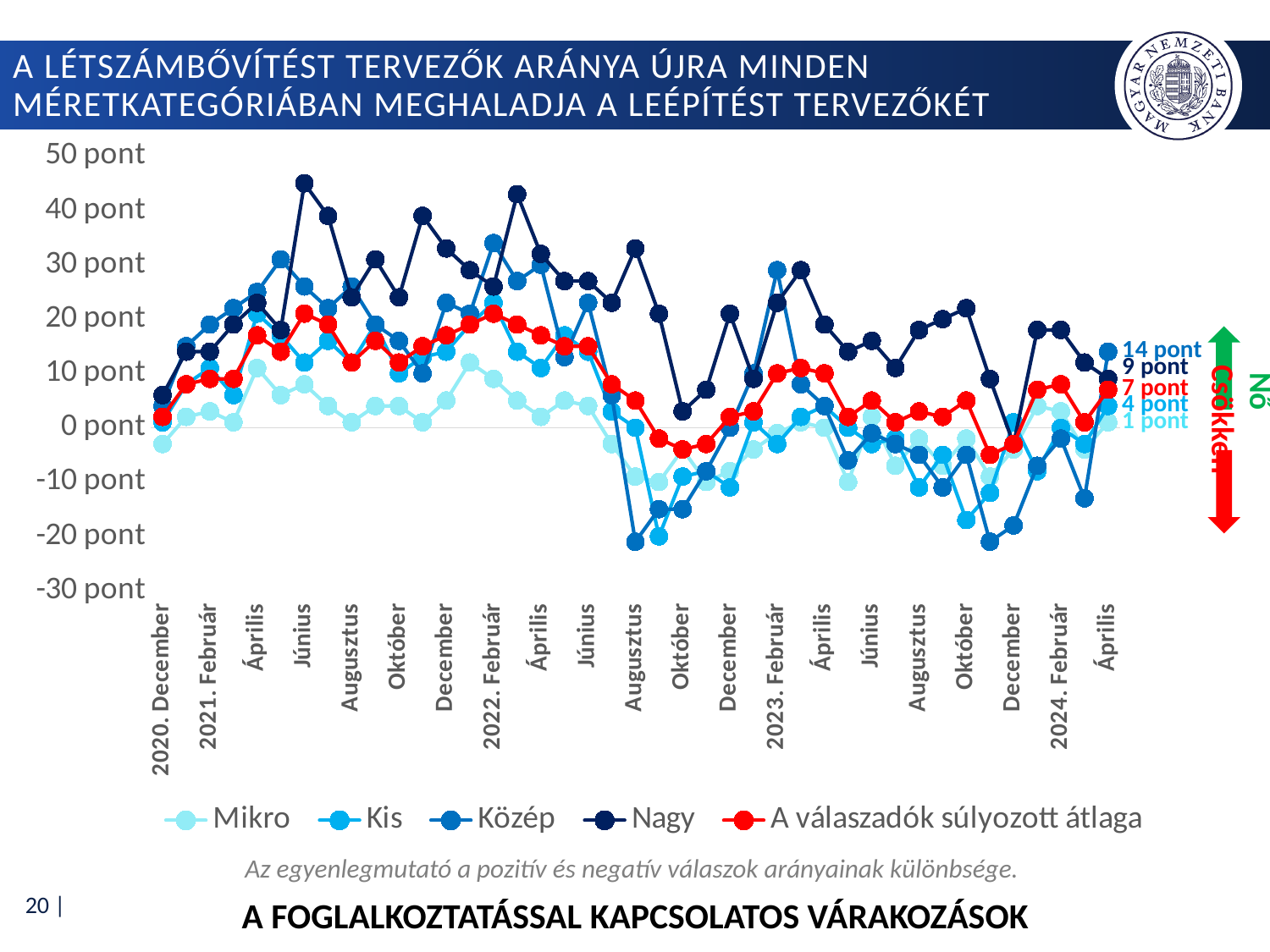
What is the latest value (2024. Április) for the Mikro series? 1 pont Which series is drawn in red in the legend? A válaszadók súlyozott átlaga What is the difference between the latest values of Közép and Mikro? 13 pont Is the value for Nagy in 2021 Június greater or less than 40 pont? greater Which series has the highest value at the last data point (2024. Április)? Közép At the last data point, which is larger: the Kis value or the Nagy value? Nagy What kind of chart is shown on the slide? line chart Which series has the lowest value at the last data point (2024. Április)? Mikro What is the latest value (2024. Április) for the Közép series? 14 pont What is the latest value (2024. Április) for the Nagy series? 9 pont How many series does the legend list? 5 What is the latest value (2024. Április) for A válaszadók súlyozott átlaga? 7 pont